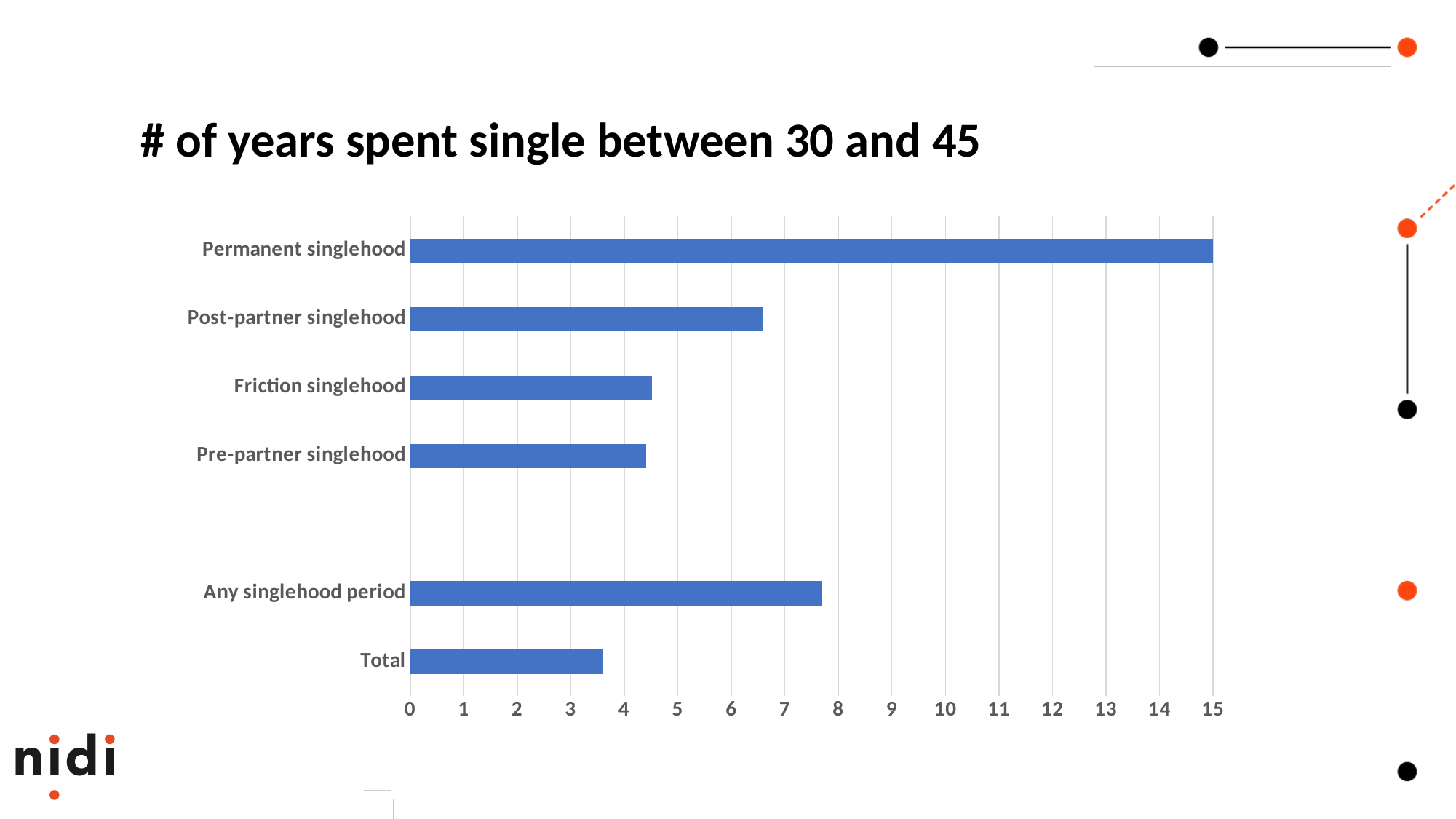
What kind of chart is shown on the slide? bar chart Which is larger, the value for Pre-partner singlehood or the value for Total? Pre-partner singlehood What is the value for Permanent singlehood? 15 Which is larger, the value for Post-partner singlehood or the value for Any singlehood period? Any singlehood period Is the value for Friction singlehood greater or less than 4? greater What is the title of the chart? # of years spent single between 30 and 45 Which category has the lowest value? Total Which category has the highest value? Permanent singlehood Is the value for Post-partner singlehood greater or less than 6? greater Is the value for Any singlehood period greater or less than 7? greater How many categories are plotted in the chart? 6